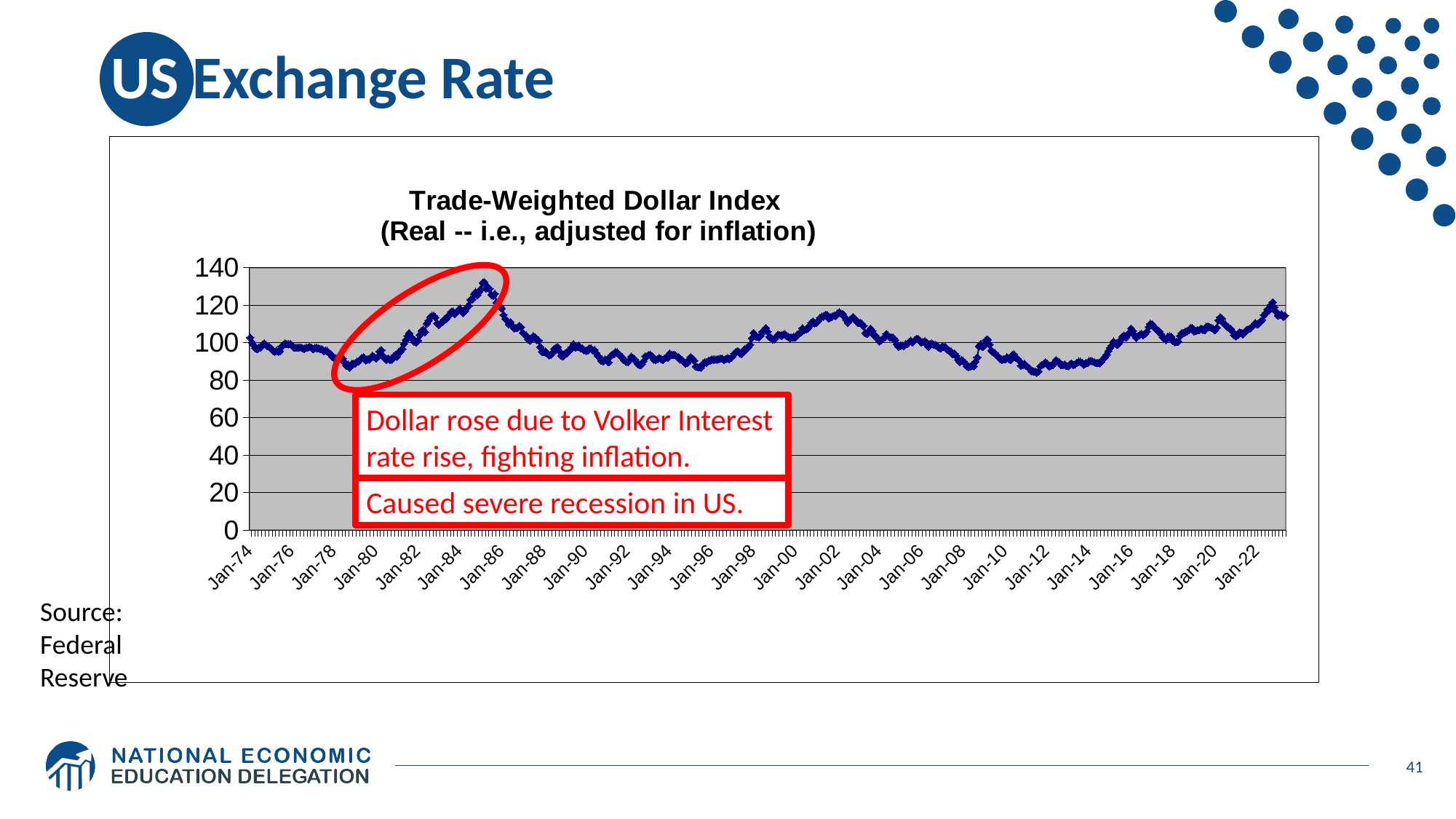
Is the value of the Trade-Weighted Dollar Index around Jan-80 greater or less than 100? less What is the highest value shown on the y axis of the chart? 140 Is the value of the Trade-Weighted Dollar Index around Jan-12 greater or less than 100? less Is the value of the Trade-Weighted Dollar Index at its mid-1980s peak greater or less than 120? greater In which period does the Trade-Weighted Dollar Index reach its highest value? The mid-1980s Which is larger, the Trade-Weighted Dollar Index around Jan-86 or around Jan-12? Jan-86 Does the Trade-Weighted Dollar Index rise or fall between Jan-02 and Jan-08? fall What is the title of the chart? Trade-Weighted Dollar Index (Real -- i.e., adjusted for inflation) What kind of chart is shown on the slide? Line chart Does the Trade-Weighted Dollar Index rise or fall between Jan-80 and Jan-85? rise